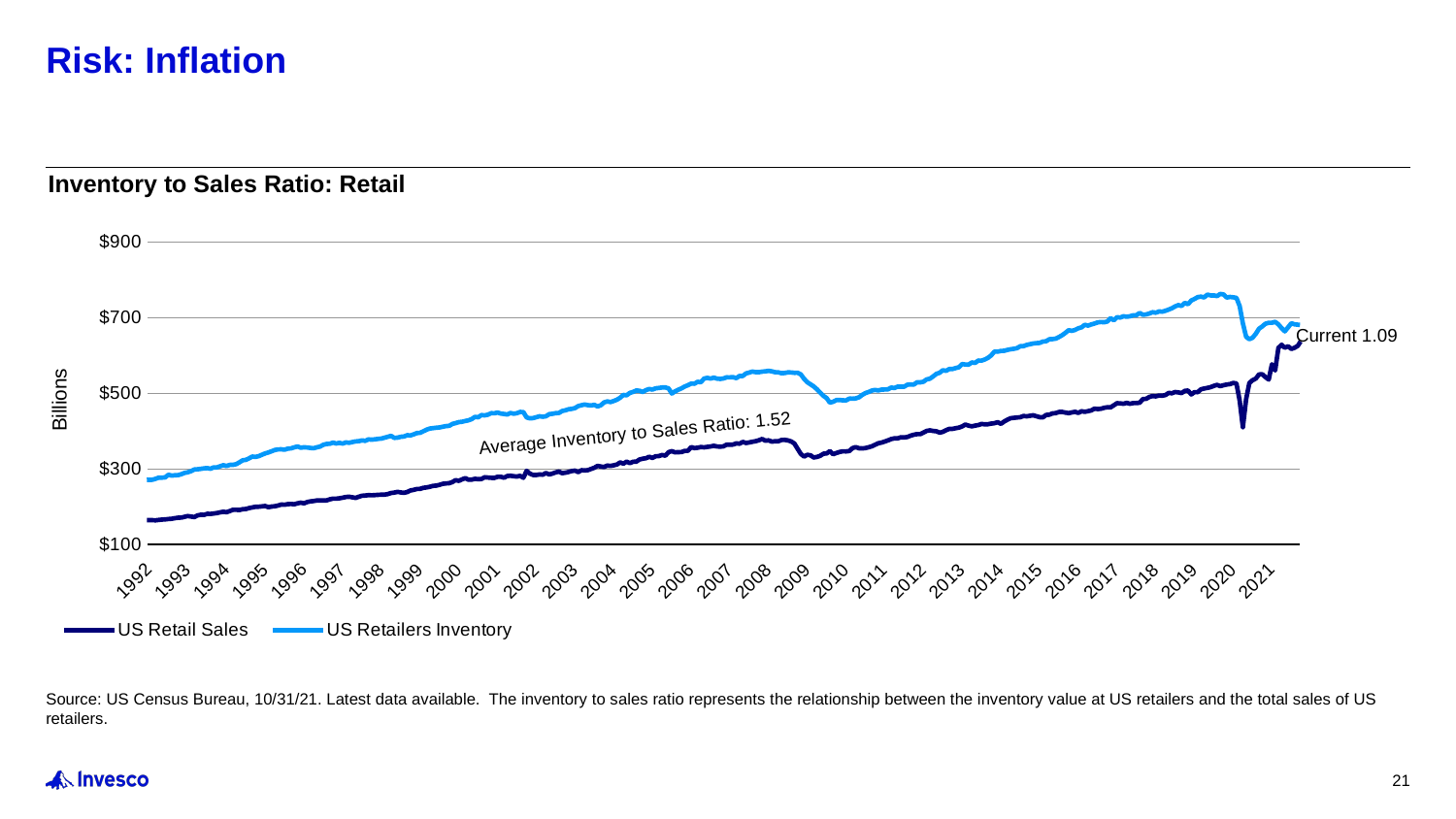
Is the value for US Retailers Inventory in 1992 greater or less than $500? less What is the current inventory to sales ratio noted on the chart? 1.09 What is the title of the chart? Inventory to Sales Ratio: Retail Is the value for US Retail Sales in 1992 greater or less than $300? less How many series does the legend list? 2 Which series is higher in 2010, US Retail Sales or US Retailers Inventory? US Retailers Inventory Is the value for US Retail Sales in 2016 greater or less than $300? greater What kind of chart is shown on the slide? line chart What is the average inventory to sales ratio noted on the chart? 1.52 What is the label of the y axis? Billions Does the US Retail Sales series generally rise or fall from 1992 to 2021? rise